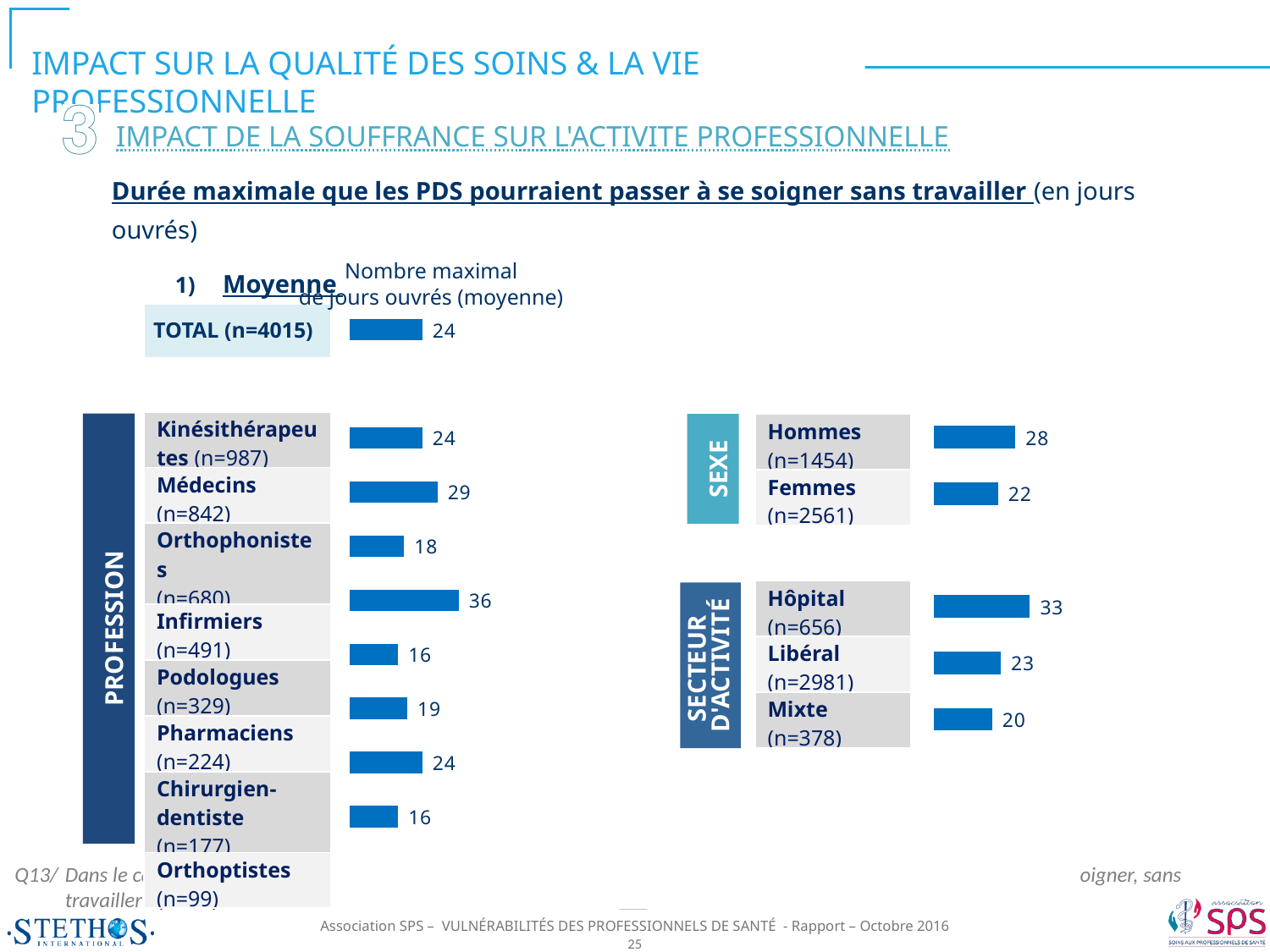
In the SECTEUR D'ACTIVITÉ chart, what is the value for Mixte? 20 In the SEXE chart, what is the value for Femmes? 22 In the SECTEUR D'ACTIVITÉ chart, which category has the lowest value? Mixte In the SEXE chart, what is the difference between the values for Hommes and Femmes? 6 In the SEXE chart, what is the value for Hommes? 28 In the PROFESSION chart, which is larger, the value for Kinésithérapeutes or the value for Médecins? Médecins In the TOTAL chart, what is the average maximum number of working days shown for TOTAL (n=4015)? 24 In the SECTEUR D'ACTIVITÉ chart, what is the value for Hôpital? 33 In the PROFESSION chart, what is the value for Médecins (n=842)? 29 What type of chart is used in the SEXE section? Bar chart In the SECTEUR D'ACTIVITÉ chart, how many categories are shown? 3 In the SECTEUR D'ACTIVITÉ chart, which category has the highest value? Hôpital